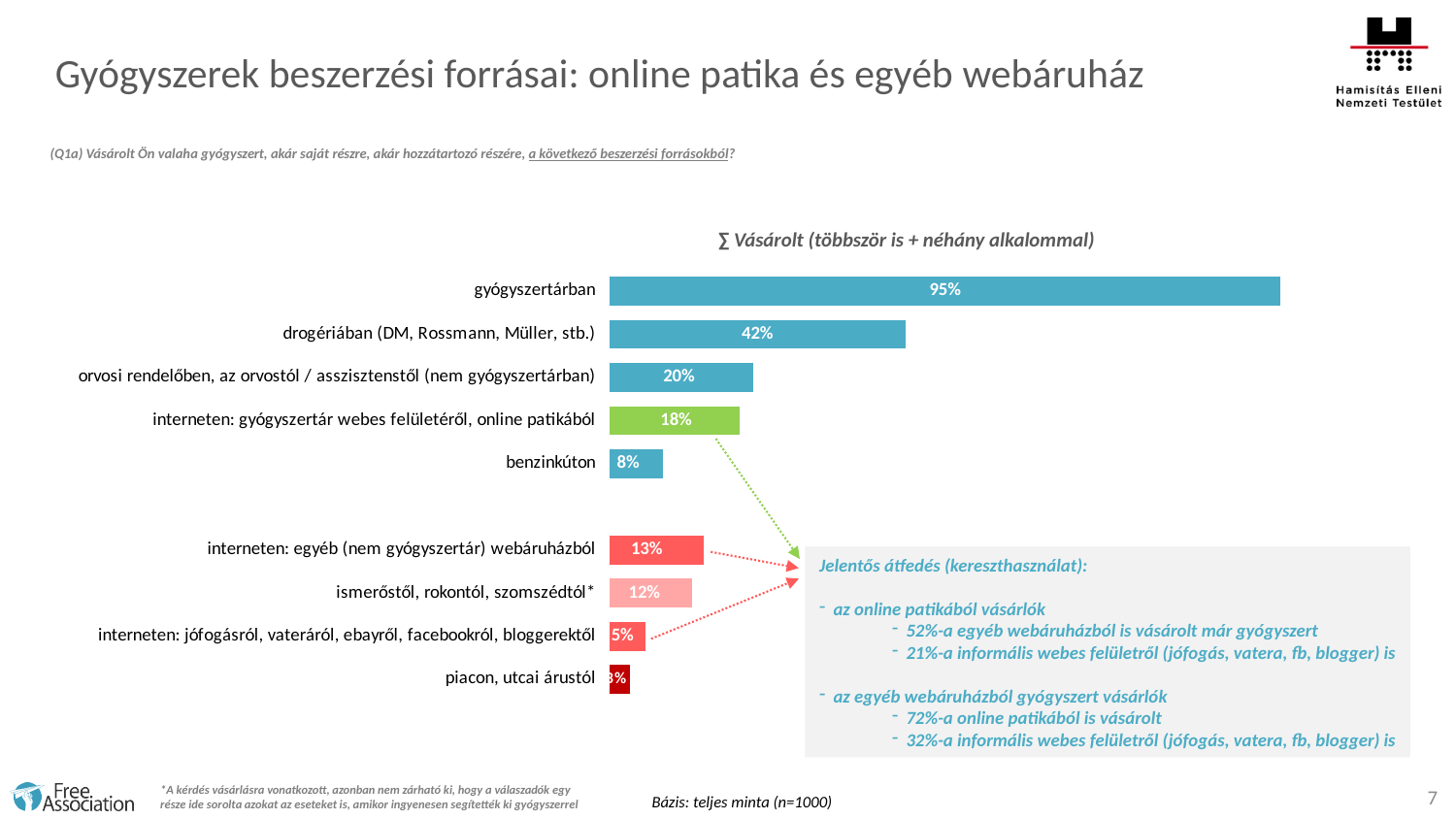
What is the value for interneten: gyógyszertár webes felületéről, online patikából? 18% How many categories are shown in the chart? 9 What is the value for drogériában (DM, Rossmann, Müller, stb.)? 42% What is the value for benzinkúton? 8% What is the title of the chart? ∑ Vásárolt (többször is + néhány alkalommal) What is the value for gyógyszertárban? 95% Which category has the highest value? gyógyszertárban What is the difference between the values for gyógyszertárban and drogériában (DM, Rossmann, Müller, stb.)? 53% Which is larger: the value for ismerőstől, rokontól, szomszédtól* or the value for interneten: jófogásról, vateráról, ebayről, facebookról, bloggerektől? ismerőstől, rokontól, szomszédtól* Which category has the lowest value? piacon, utcai árustól What kind of chart is shown on the slide? bar chart What is the value for interneten: egyéb (nem gyógyszertár) webáruházból? 13%